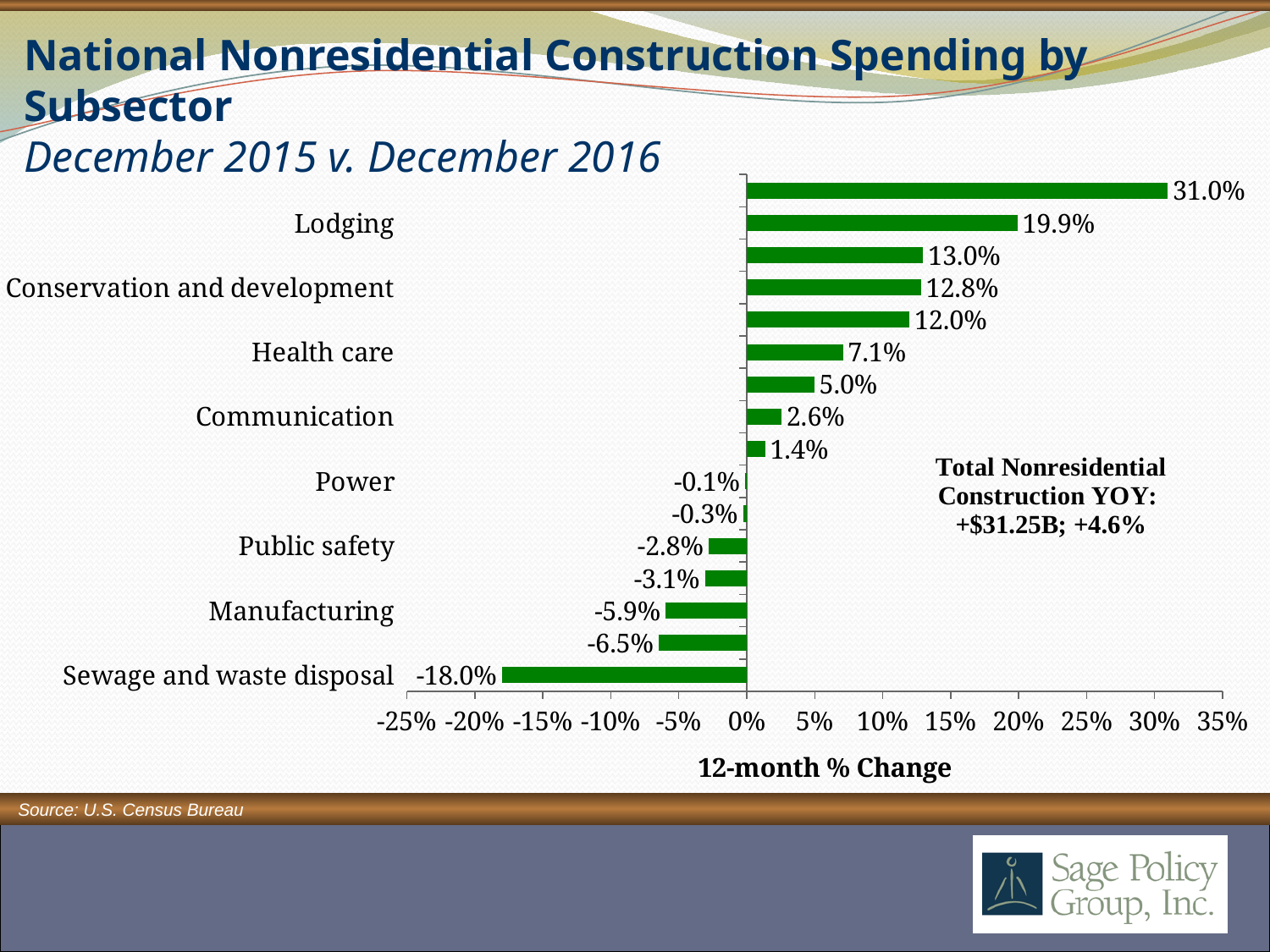
What is the largest 12-month % change value shown on the chart? 31.0% What is the difference in percentage points between the 12-month % change for Lodging and for Conservation and development? 7.1 percentage points What is the 12-month % change for Health care? 7.1% What is the 12-month % change for Sewage and waste disposal? -18.0% Which has a larger 12-month % change, Health care or Communication? Health care How many bars are plotted on the chart? 16 What is the 12-month % change for Manufacturing? -5.9% What is the title of the horizontal axis? 12-month % Change Which labeled subsector has the lowest 12-month % change? Sewage and waste disposal What is the 12-month % change for Power? -0.1% What is the 12-month % change for Lodging? 19.9% What kind of chart is shown on the slide? Bar chart